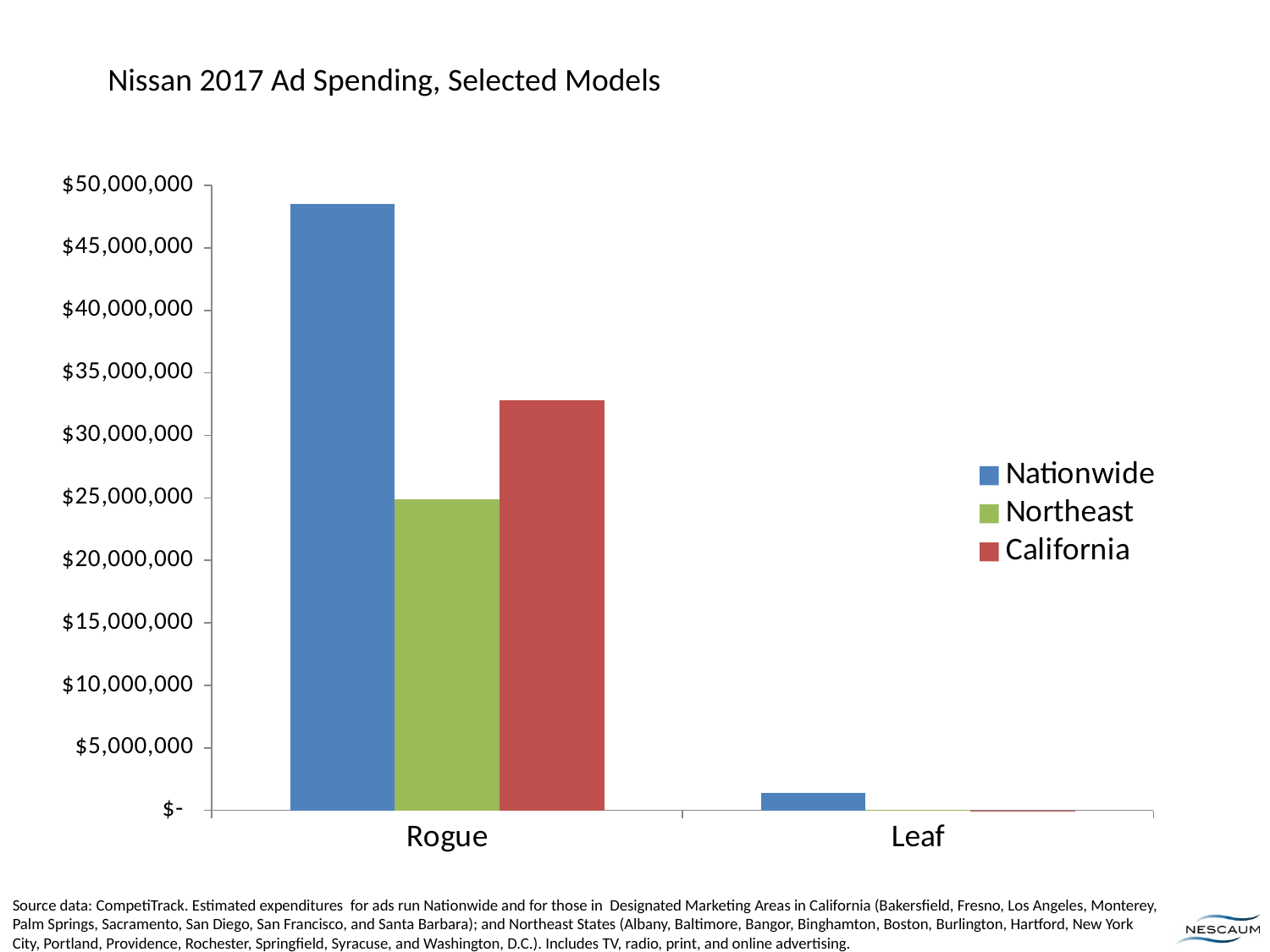
What is the title of the chart? Nissan 2017 Ad Spending, Selected Models Which series has the highest ad spending for the Rogue? Nationwide For the Rogue, is California ad spending larger or smaller than Northeast ad spending? larger Which series has the lowest ad spending for the Rogue? Northeast Which colour represents the California series in the legend? red How many models (categories) are shown on the x axis? 2 Is the Nationwide ad spending for the Leaf greater or less than $5,000,000? less What kind of chart is shown on the slide? bar chart Is the Nationwide ad spending for the Rogue greater or less than $45,000,000? greater Which model has higher Nationwide ad spending, Rogue or Leaf? Rogue Is the California ad spending for the Rogue greater or less than $35,000,000? less How many series does the legend list? 3